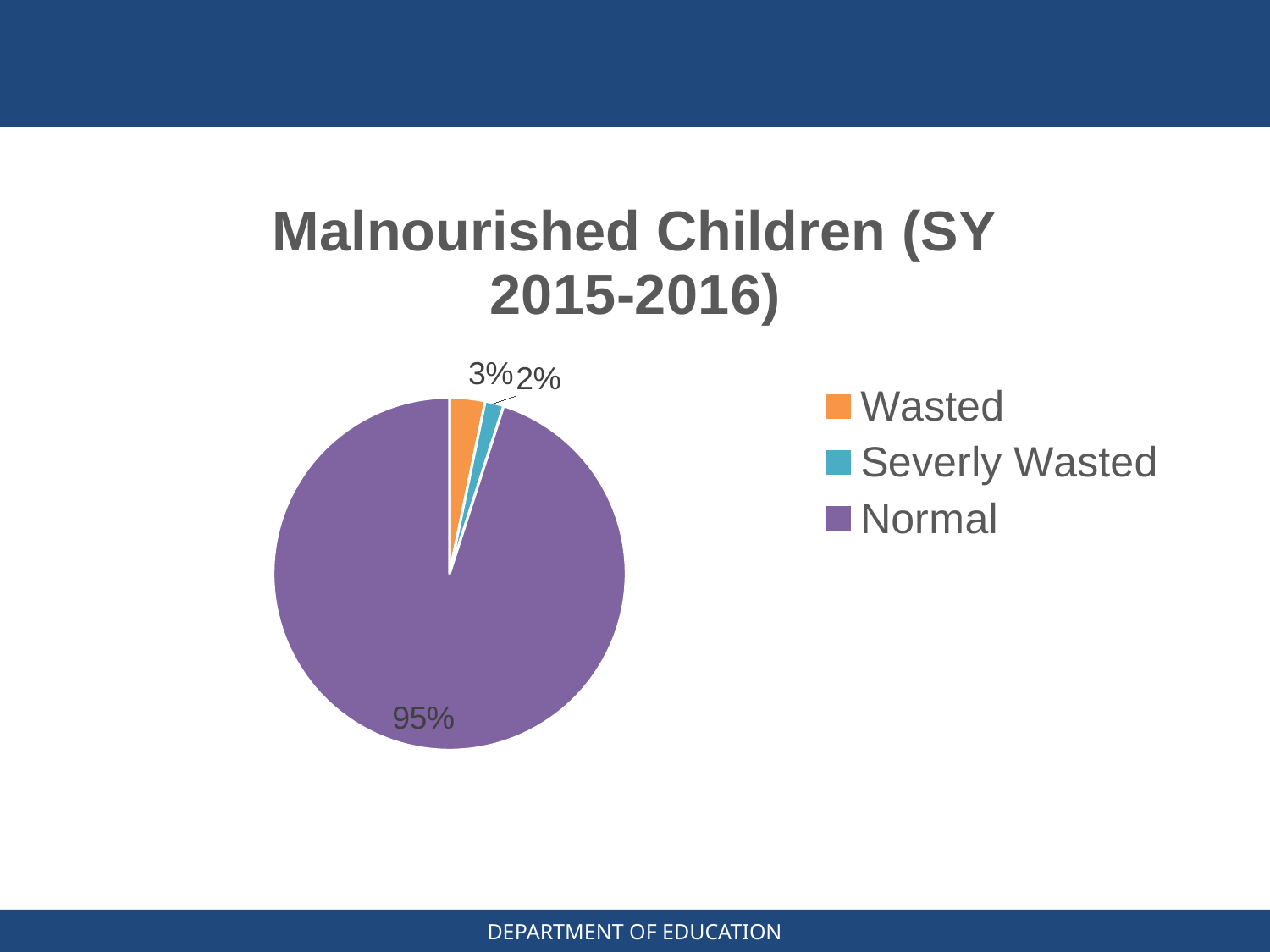
What is the difference between the Normal share and the Wasted share? 92% What percentage of the pie is labelled Wasted? 3% What percentage of the pie is labelled Normal? 95% What is the combined share of Wasted and Severly Wasted? 5% How many categories does the legend list? 3 Which is larger, the share for Wasted or the share for Severly Wasted? Wasted What is the title of the chart? Malnourished Children (SY 2015-2016) Which category has the largest share of the pie? Normal Which category has the smallest share of the pie? Severly Wasted What colour represents the Normal category in the pie chart? purple What type of chart is shown on the slide? pie chart What percentage of the pie is labelled Severly Wasted? 2%